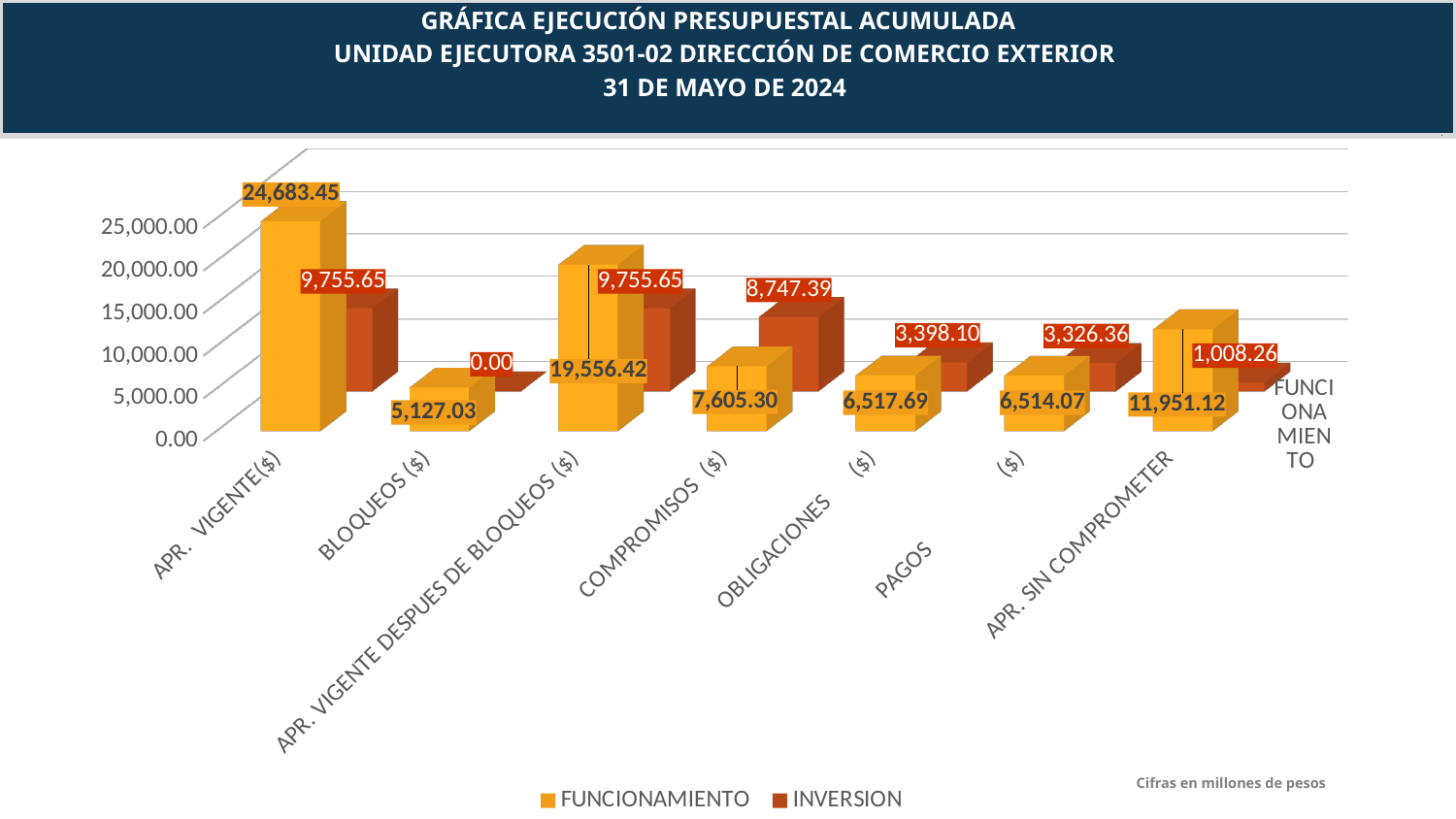
What is the difference between the FUNCIONAMIENTO values for APR. VIGENTE($) and APR. VIGENTE DESPUES DE BLOQUEOS ($)? 5,127.03 Which is larger for COMPROMISOS ($): the FUNCIONAMIENTO value or the INVERSION value? INVERSION What is the INVERSION value for COMPROMISOS ($)? 8,747.39 What kind of chart is shown on the slide? bar chart What is the FUNCIONAMIENTO value for APR. SIN COMPROMETER? 11,951.12 How many categories are shown on the x axis? 7 Which category has the lowest INVERSION value? BLOQUEOS ($) Is the FUNCIONAMIENTO value for PAGOS ($) greater or less than 10,000.00? less What is the INVERSION value for BLOQUEOS ($)? 0.00 What is the FUNCIONAMIENTO value for APR. VIGENTE($)? 24,683.45 Which category has the highest FUNCIONAMIENTO value? APR. VIGENTE($) How many series does the legend list? 2